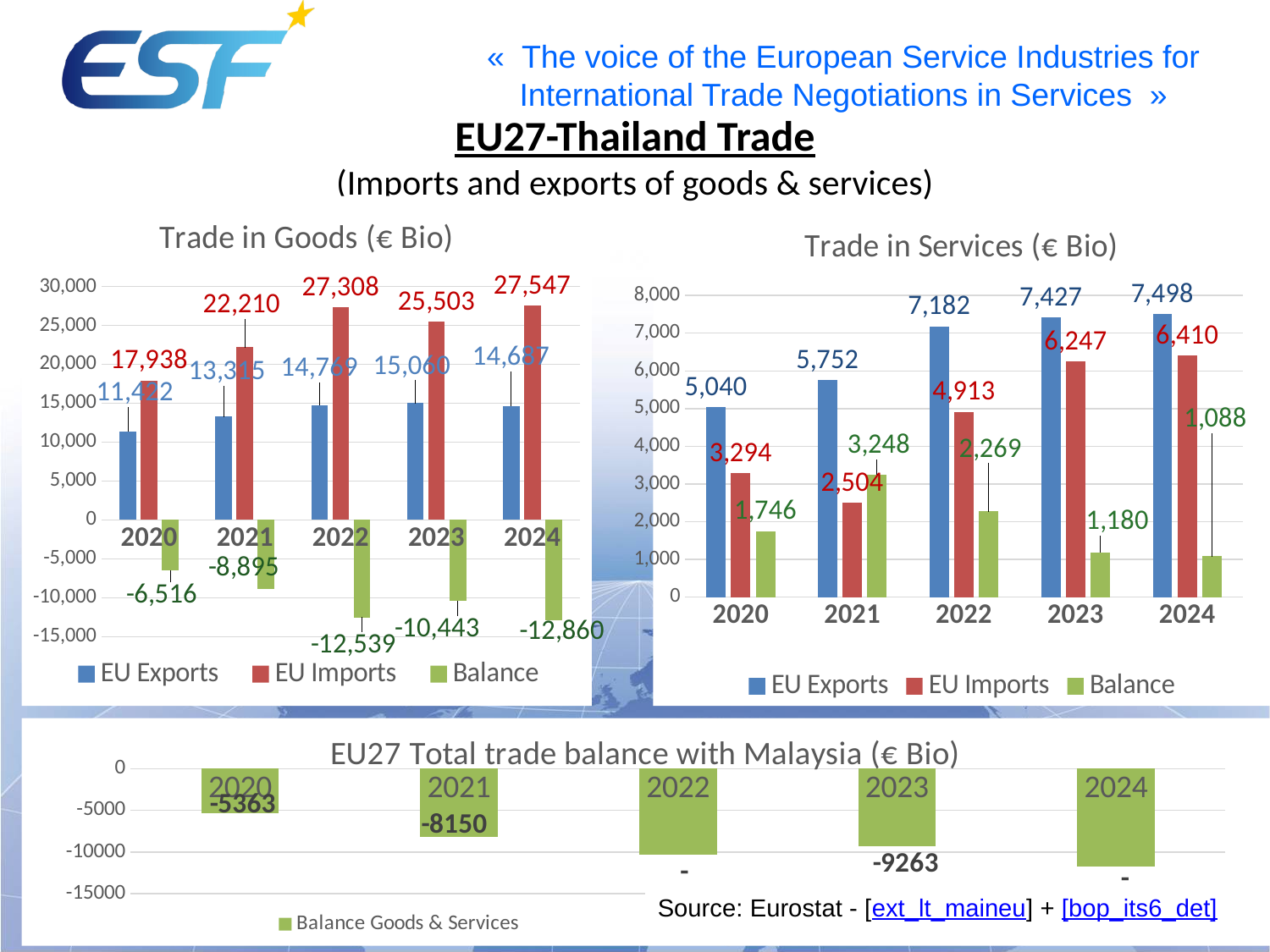
In the Trade in Services (€ Bio) chart, do EU Exports rise or fall from 2020 to 2024? rise In the EU27 Total trade balance with Malaysia (€ Bio) chart, what is the value for 2021? -8150 In the Trade in Goods (€ Bio) chart, which year has the highest EU Imports value? 2024 In the Trade in Services (€ Bio) chart, is the value for EU Imports in 2023 greater or less than 6,000? greater In the Trade in Goods (€ Bio) chart, what is the Balance value for 2022? -12,539 In the Trade in Services (€ Bio) chart, what is the value of EU Exports in 2022? 7,182 In the Trade in Services (€ Bio) chart, which year has the lowest EU Imports value? 2021 In the Trade in Services (€ Bio) chart, which year has the highest Balance value? 2021 In the Trade in Goods (€ Bio) chart, what is the value of EU Imports in 2024? 27,547 How many series does the legend of the Trade in Goods (€ Bio) chart list? 3 In the Trade in Goods (€ Bio) chart, what is the difference between EU Imports and EU Exports in 2021? 8,895 In the EU27 Total trade balance with Malaysia (€ Bio) chart, which of 2020 and 2023 has the larger (less negative) balance? 2020